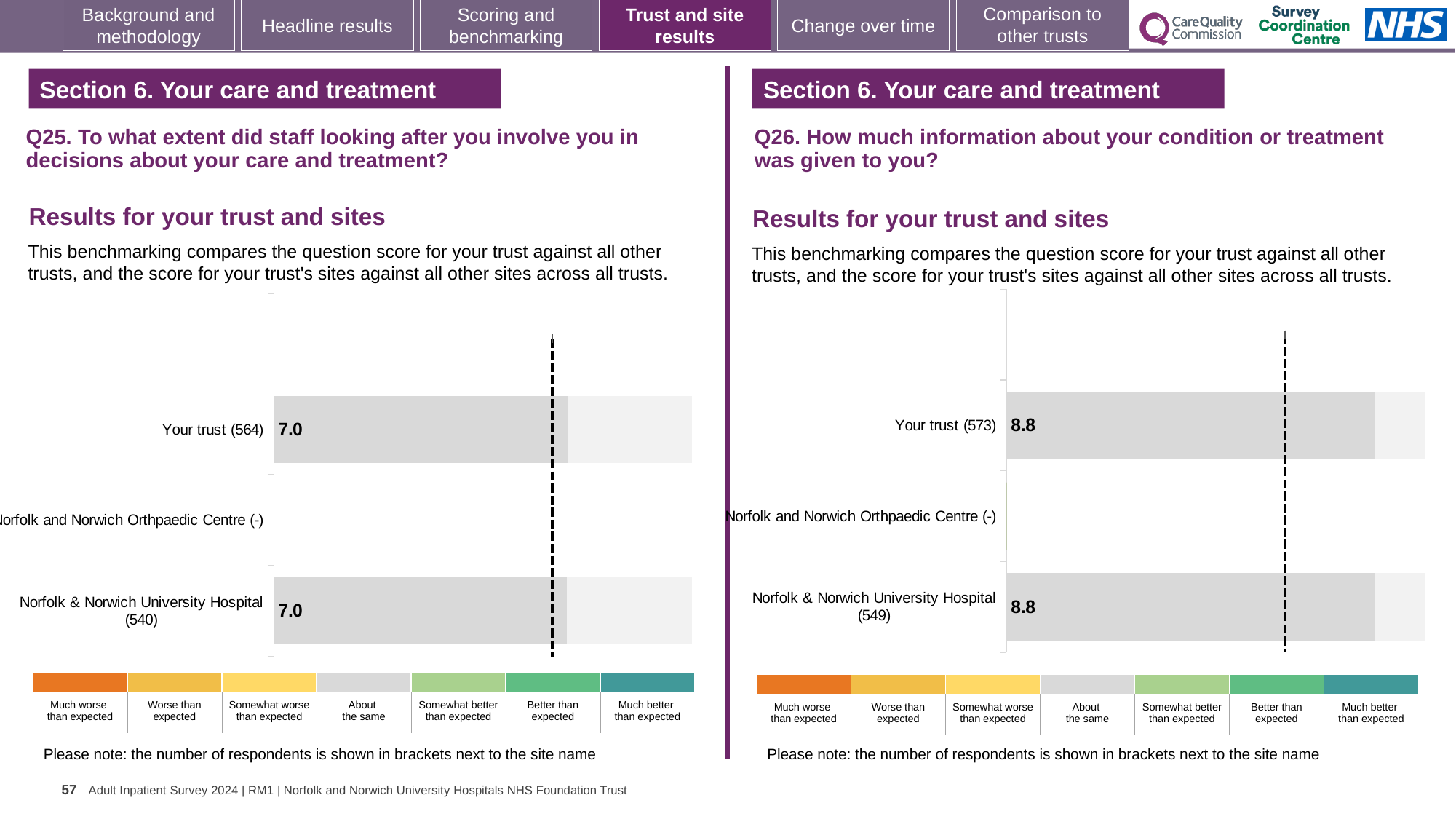
What kind of chart is the Q25 chart on the left? Bar chart In the Q26 chart on the right, which category has no bar plotted? Norfolk and Norwich Orthpaedic Centre (-) How many categories are listed on the y axis of the Q25 chart on the left? 3 In the Q26 chart on the right, what is the score for Norfolk & Norwich University Hospital (549)? 8.8 In the Q25 chart on the left, what is the score for Norfolk & Norwich University Hospital (540)? 7.0 In the Q25 chart on the left, what is the score for Your trust (564)? 7.0 In the Q26 chart on the right, how many respondents are shown in brackets for Norfolk & Norwich University Hospital? 549 In the Q25 chart on the left, how many respondents are shown in brackets for Your trust? 564 In the Q26 chart on the right, what is the difference between the score for Your trust (573) and the score for Norfolk & Norwich University Hospital (549)? 0.0 In the Q25 chart on the left, what is the difference between the score for Your trust (564) and the score for Norfolk & Norwich University Hospital (540)? 0.0 How many categories are listed on the y axis of the Q26 chart on the right? 3 In the Q26 chart on the right, what is the score for Your trust (573)? 8.8